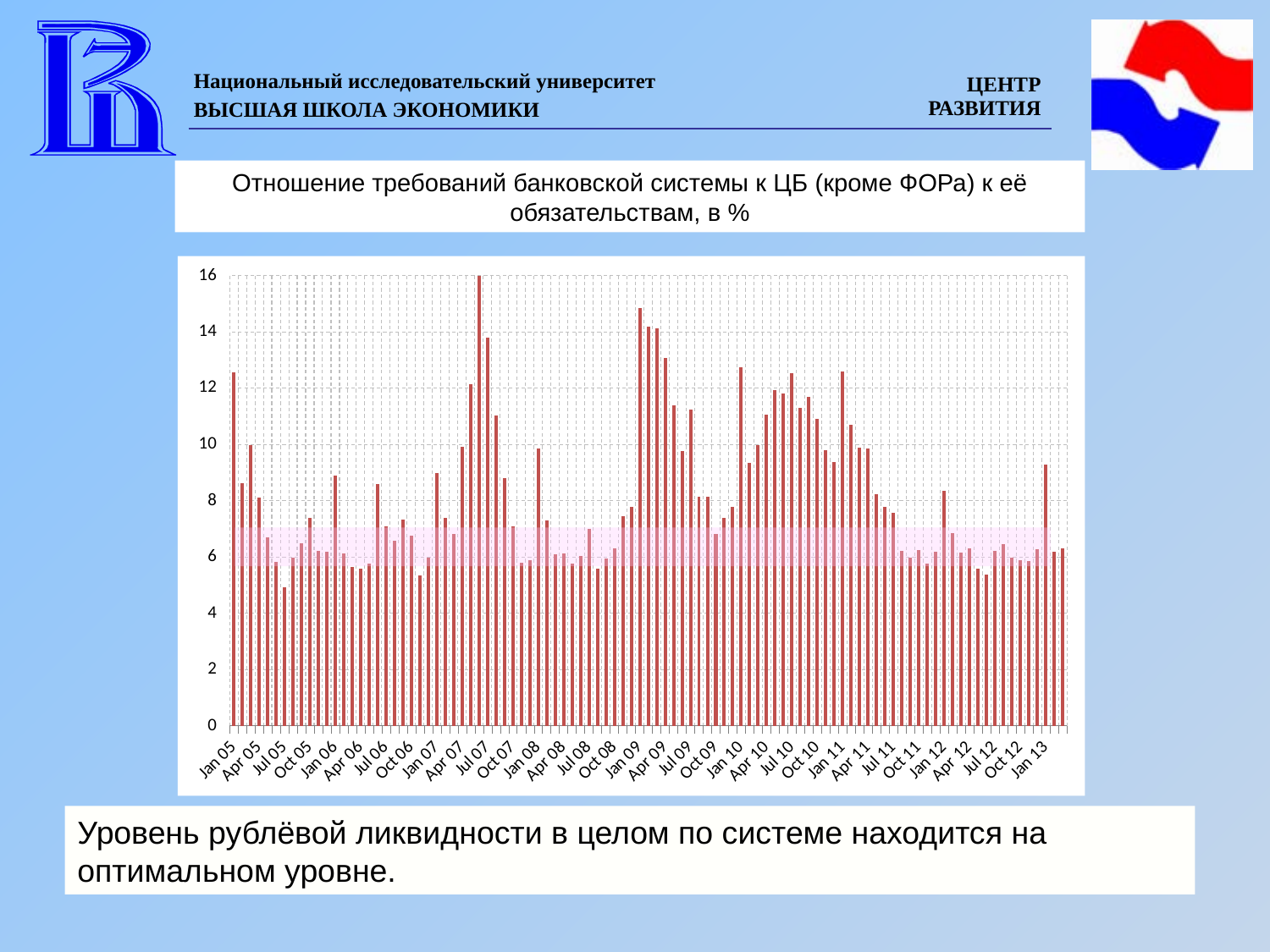
In which year does the tallest bar of the chart occur? 2007 Is the tallest bar in the chart greater or less than 14? greater Is the value for Jan 13 greater or less than 8? greater Do the values rise or fall from Apr 11 to Oct 11? fall What kind of chart is shown on the slide? bar chart Is the value for Jan 05 greater or less than 10? greater Which is larger, the value for Jan 05 or the value for Jul 05? Jan 05 What is the highest value shown on the vertical axis of the chart? 16 What is the title of the chart? Отношение требований банковской системы к ЦБ (кроме ФОРа) к её обязательствам, в % Do the values rise or fall from Jan 09 to Oct 09? fall